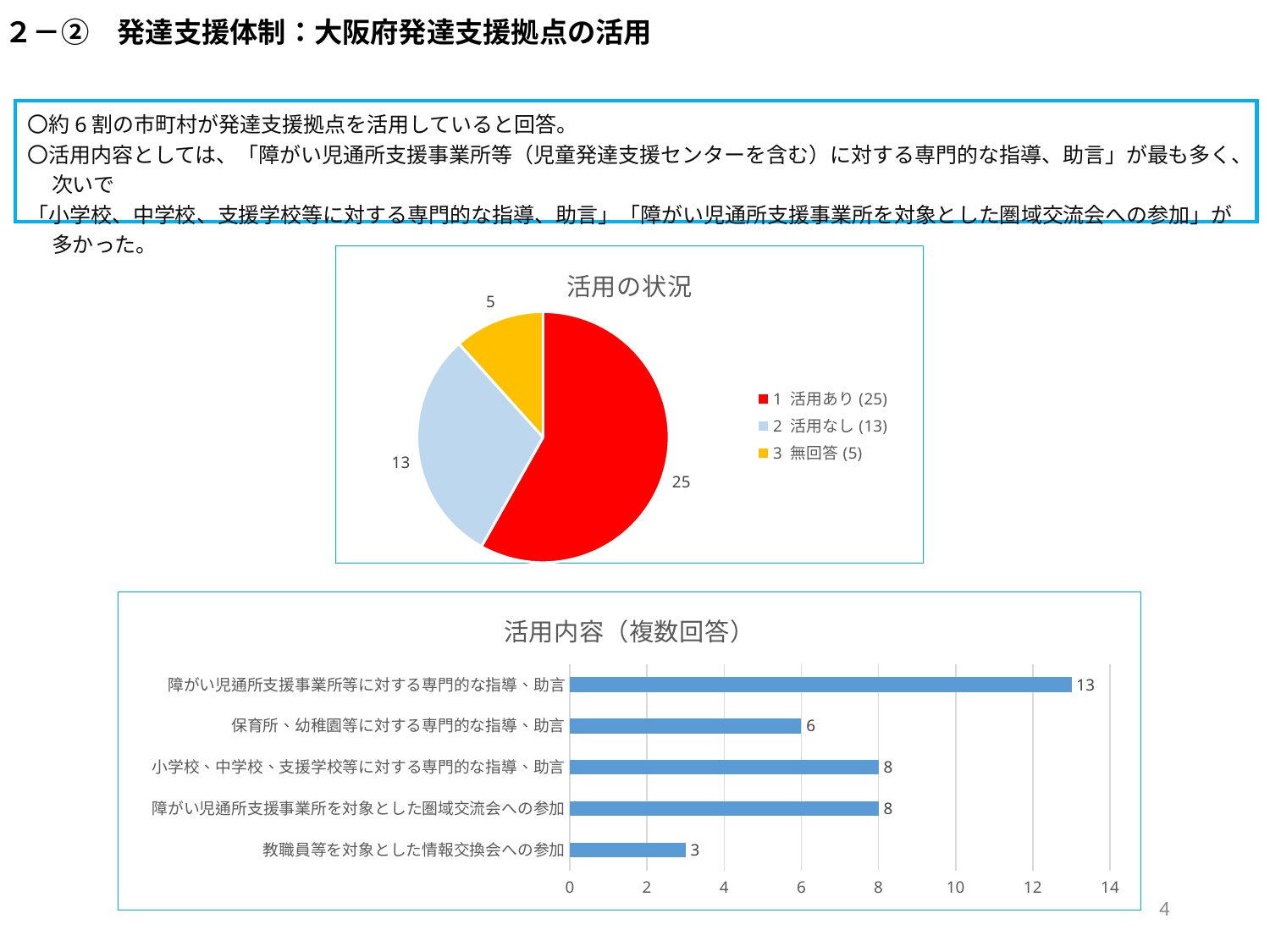
What kind of chart is the chart titled 活用の状況? pie chart In the chart titled 活用内容（複数回答）, what is the value for 保育所、幼稚園等に対する専門的な指導、助言? 6 In the chart titled 活用内容（複数回答）, what is the difference between 障がい児通所支援事業所等に対する専門的な指導、助言 and 教職員等を対象とした情報交換会への参加? 10 In the chart titled 活用の状況, what is the value for 無回答? 5 In the chart titled 活用の状況, what is the difference between 活用あり and 活用なし? 12 In the chart titled 活用の状況, which category has the largest slice? 活用あり What kind of chart is the chart titled 活用内容（複数回答）? bar chart In the chart titled 活用内容（複数回答）, which category has the highest value? 障がい児通所支援事業所等に対する専門的な指導、助言 In the chart titled 活用の状況, how many categories does the legend list? 3 In the chart titled 活用内容（複数回答）, which category has the lowest value? 教職員等を対象とした情報交換会への参加 In the chart titled 活用の状況, what is the value for 活用あり? 25 In the chart titled 活用内容（複数回答）, how many categories are shown? 5